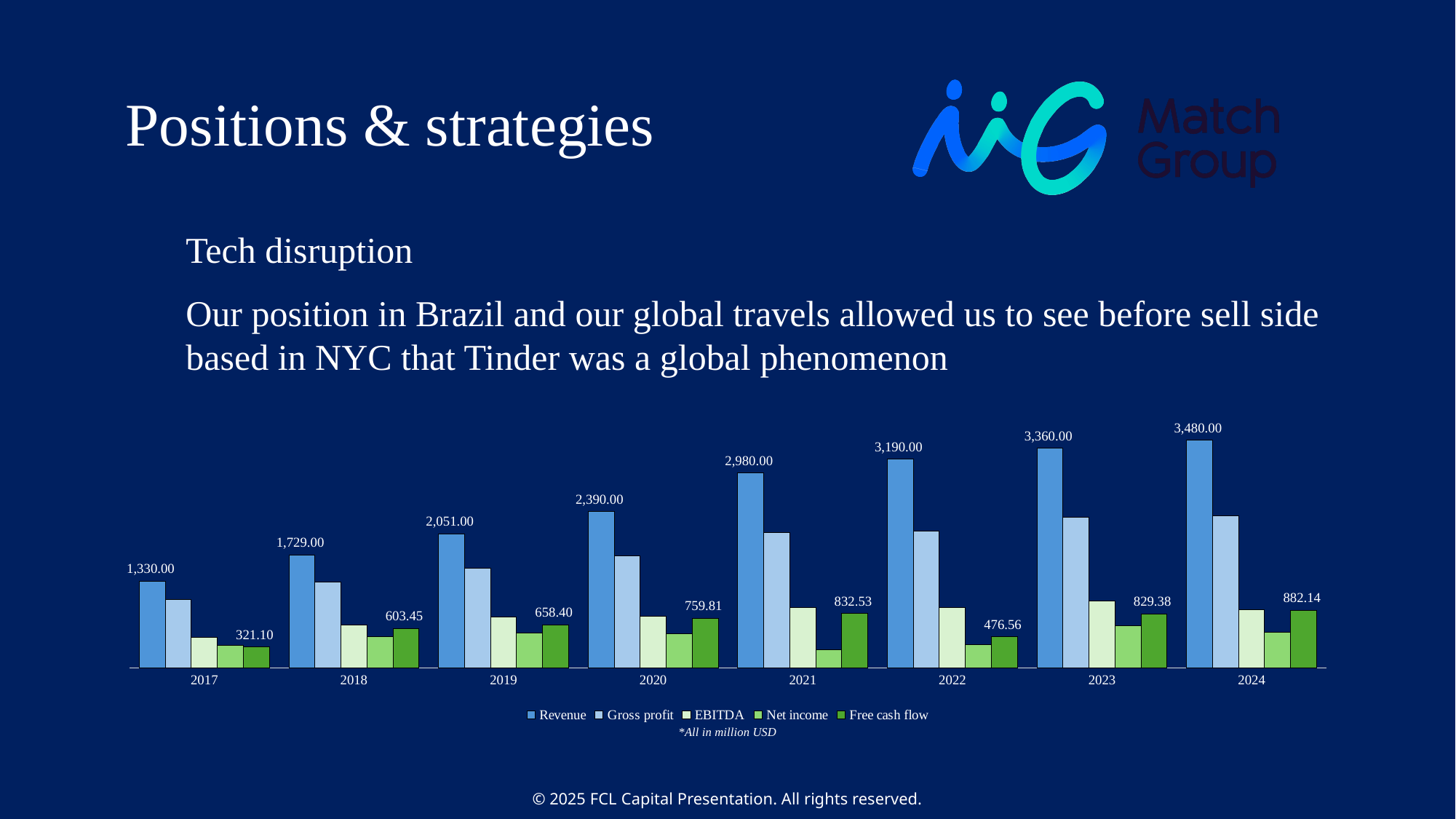
Which year has the lowest Free cash flow? 2017 What is the difference in Revenue between 2024 and 2023? 120.00 What is the Revenue value for 2020? 2,390.00 How many series does the legend list? 5 How many years are shown on the x axis? 8 Which is larger, Free cash flow in 2023 or Free cash flow in 2024? 2024 What is the difference in Free cash flow between 2021 and 2022? 355.97 Does Revenue rise or fall from 2017 to 2024? rise What is the Free cash flow value for 2017? 321.10 What is the Free cash flow value for 2022? 476.56 What is the Revenue value for 2024? 3,480.00 Which year has the highest Revenue? 2024